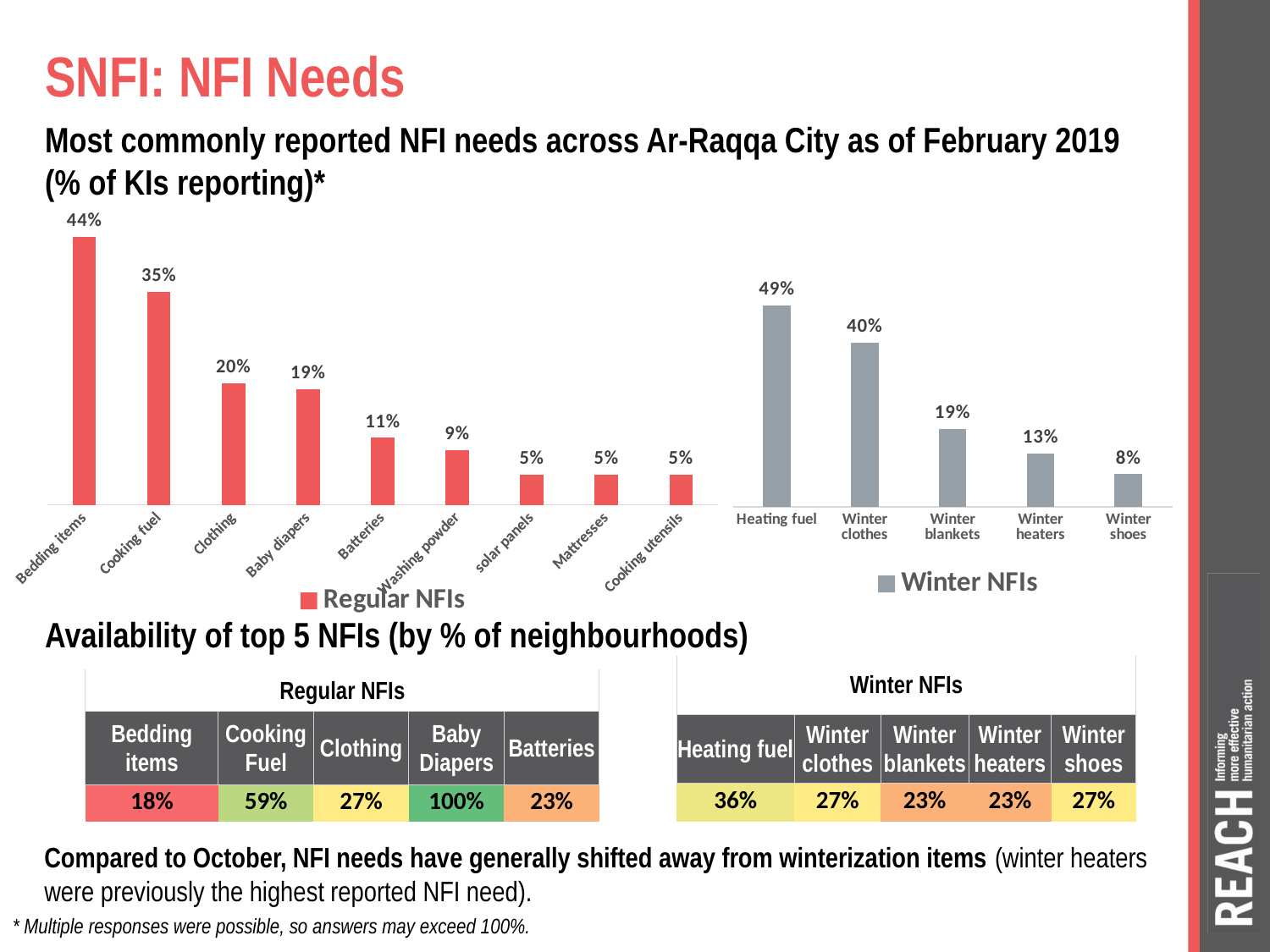
What type of chart is the Winter NFIs chart? Bar chart In the Winter NFIs chart, what is the value for winter blankets? 19% In the Winter NFIs chart, which category has the lowest value? Winter shoes In the Regular NFIs chart, which is larger: the value for baby diapers or the value for batteries? Baby diapers In the Winter NFIs chart, do the values rise or fall from left to right? Fall In the Winter NFIs chart, what is the difference between heating fuel and winter clothes? 9% How many categories are shown in the Regular NFIs chart? 9 In the Regular NFIs chart, what percentage of KIs reported bedding items as a need? 44% What colour are the bars in the Regular NFIs chart? Red How many categories are shown in the Winter NFIs chart? 5 In the Regular NFIs chart, what is the difference between the values for cooking fuel and clothing? 15% In the Regular NFIs chart, which category has the highest value? Bedding items